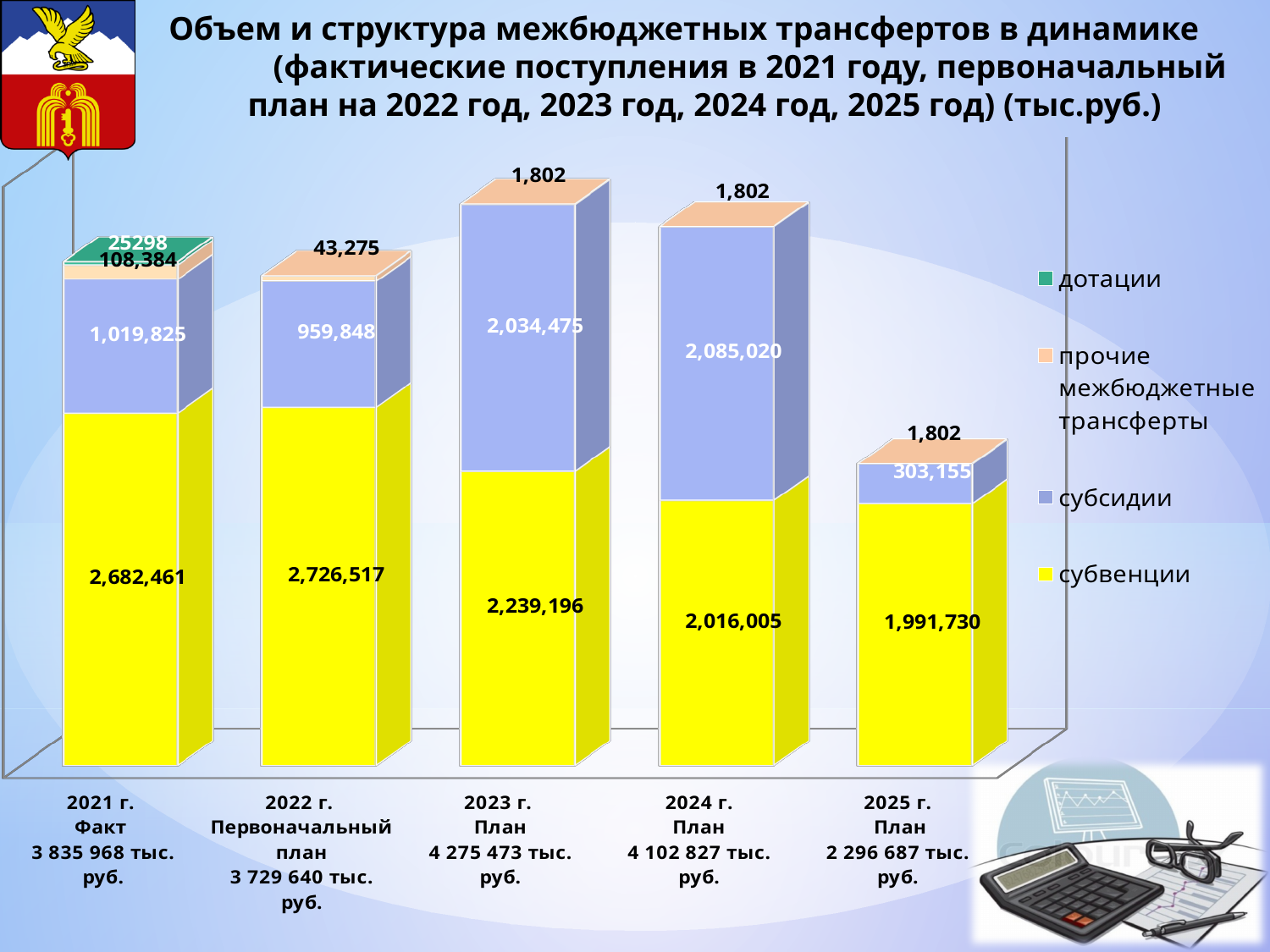
What kind of chart is shown on the slide? stacked bar chart What is the difference between субсидии in 2024 г. and субсидии in 2023 г.? 50,545 In 2024 г. План, which is larger: субвенции or субсидии? субсидии Which year has the highest value of субвенции? 2022 г. Which year has the lowest value of субсидии? 2025 г. How many series does the legend list? 4 What is the value of субвенции for 2023 г. План? 2,239,196 What is the value of субсидии for 2024 г. План? 2,085,020 What is the value of прочие межбюджетные трансферты for 2022 г. Первоначальный план? 43,275 What is the value of дотации for 2021 г. Факт? 25298 What is the total of the stacked bar for 2025 г. План? 2 296 687 тыс. руб. How many years (categories) are shown on the x axis? 5